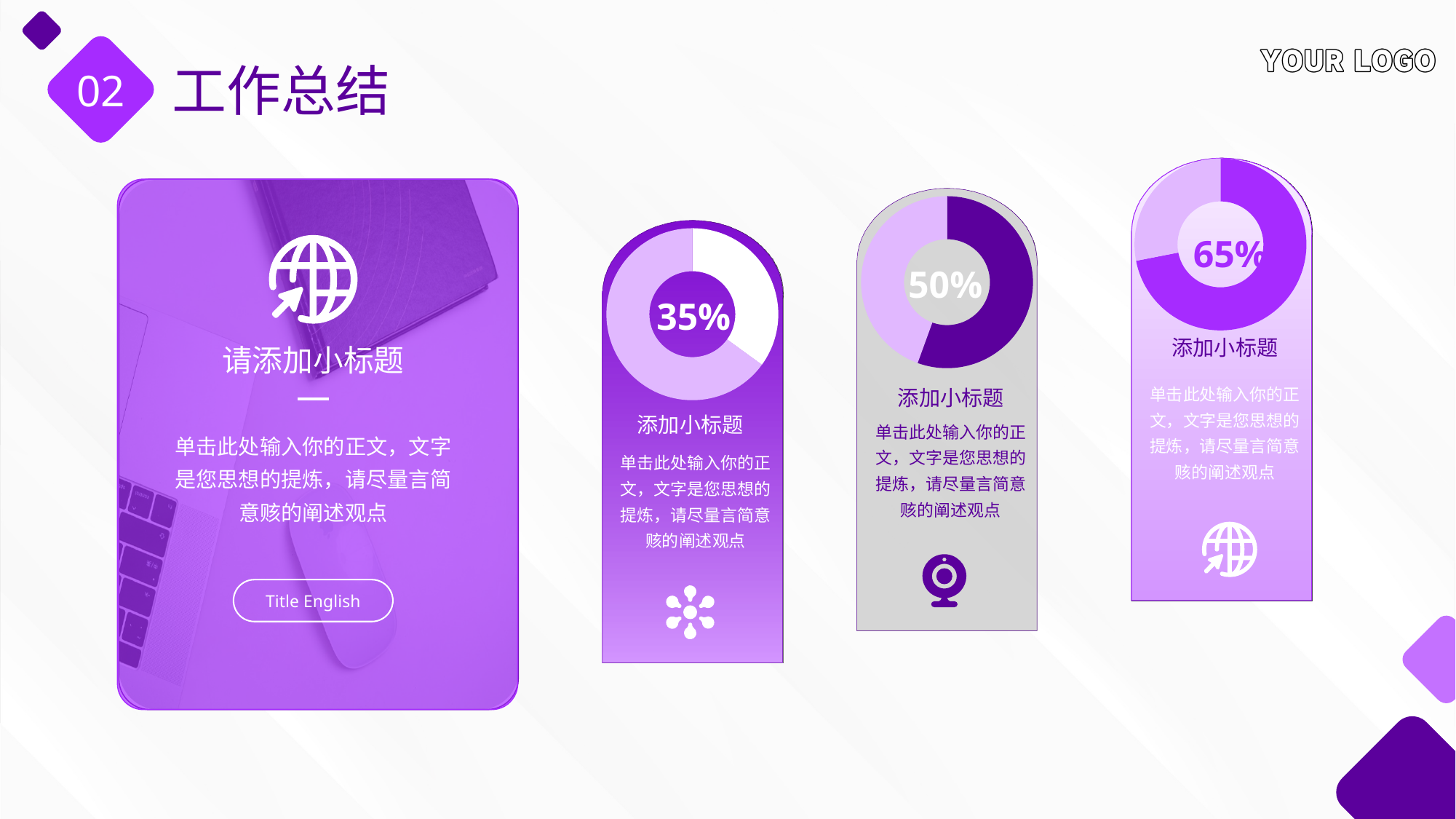
Is the percentage in the rightmost donut chart greater or less than 50%? greater What percentage is shown in the centre of the middle donut chart? 50% How many donut charts are on the slide? 3 Do the percentages in the donut charts increase or decrease from left to right across the slide? Increase What percentage is shown in the centre of the leftmost donut chart? 35% What is the difference between the percentage in the middle donut chart and the percentage in the leftmost donut chart? 15% What kind of chart is used to display the percentages on this slide? Donut chart What is the difference between the percentage in the rightmost donut chart and the percentage in the leftmost donut chart? 30% Which shows a larger percentage, the middle donut chart or the rightmost donut chart? The rightmost donut chart What percentage is shown in the centre of the rightmost donut chart? 65% Which of the three donut charts shows the highest percentage? The rightmost one (65%) Which of the three donut charts shows the lowest percentage? The leftmost one (35%)